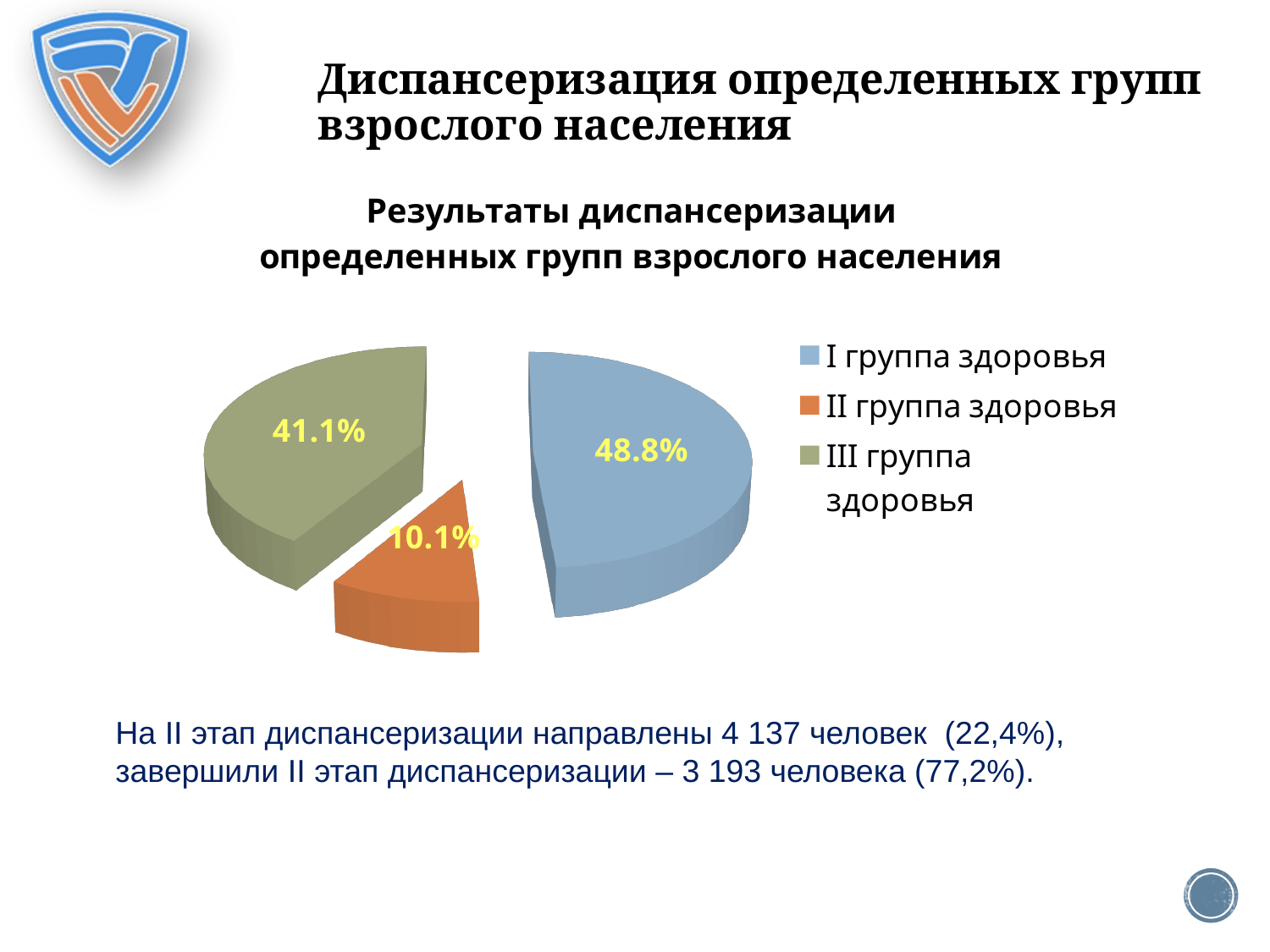
What is the difference in percentage points between III группа здоровья and II группа здоровья? 31 Which health group has the smallest slice of the pie? II группа здоровья How many entries does the legend list? 3 What colour is the slice for II группа здоровья? orange What is the difference in percentage points between I группа здоровья and III группа здоровья? 7.7 What share of the pie does II группа здоровья have? 10.1% How many slices does the pie chart have? 3 What share of the pie does I группа здоровья have? 48.8% Which is larger, the slice for I группа здоровья or the slice for III группа здоровья? I группа здоровья Which health group has the largest slice of the pie? I группа здоровья What kind of chart is shown on the slide? pie chart What share of the pie does III группа здоровья have? 41.1%